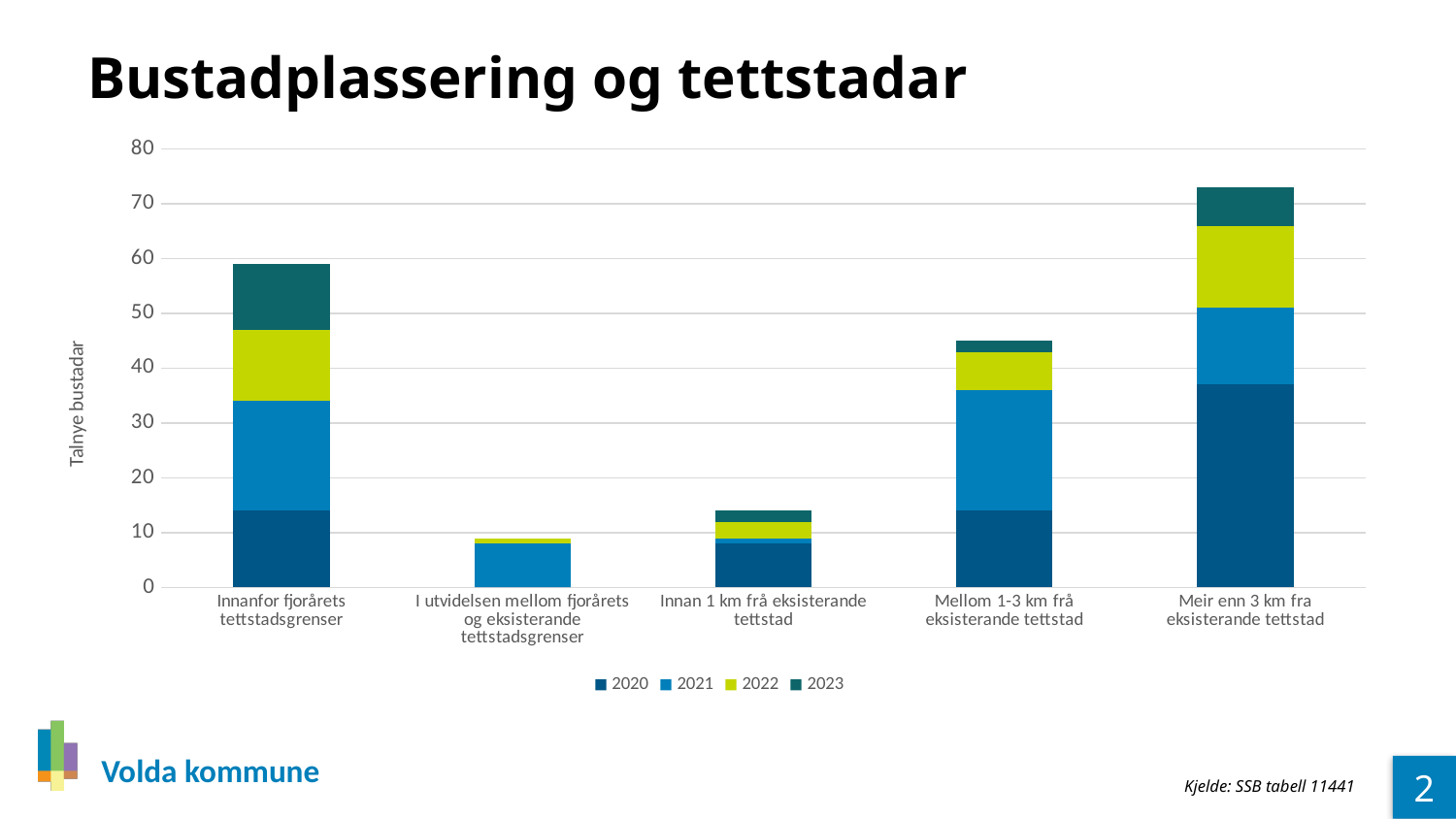
What kind of chart is shown on the slide? Stacked bar chart Which has the larger total stacked bar: 'Innanfor fjorårets tettstadsgrenser' or 'Mellom 1-3 km frå eksisterande tettstad'? Innanfor fjorårets tettstadsgrenser Is the total stacked value for 'Innanfor fjorårets tettstadsgrenser' greater or less than 50? greater How many series does the legend list? 4 Which category has the shortest stacked bar? I utvidelsen mellom fjorårets og eksisterande tettstadsgrenser Which category has the tallest stacked bar? Meir enn 3 km fra eksisterande tettstad What are the series listed in the legend? 2020, 2021, 2022, 2023 Is the total stacked value for 'I utvidelsen mellom fjorårets og eksisterande tettstadsgrenser' greater or less than 10? less Is the total stacked value for 'Mellom 1-3 km frå eksisterande tettstad' greater or less than 50? less How many categories are shown along the x axis? 5 What is the label on the y axis? Talnye bustadar